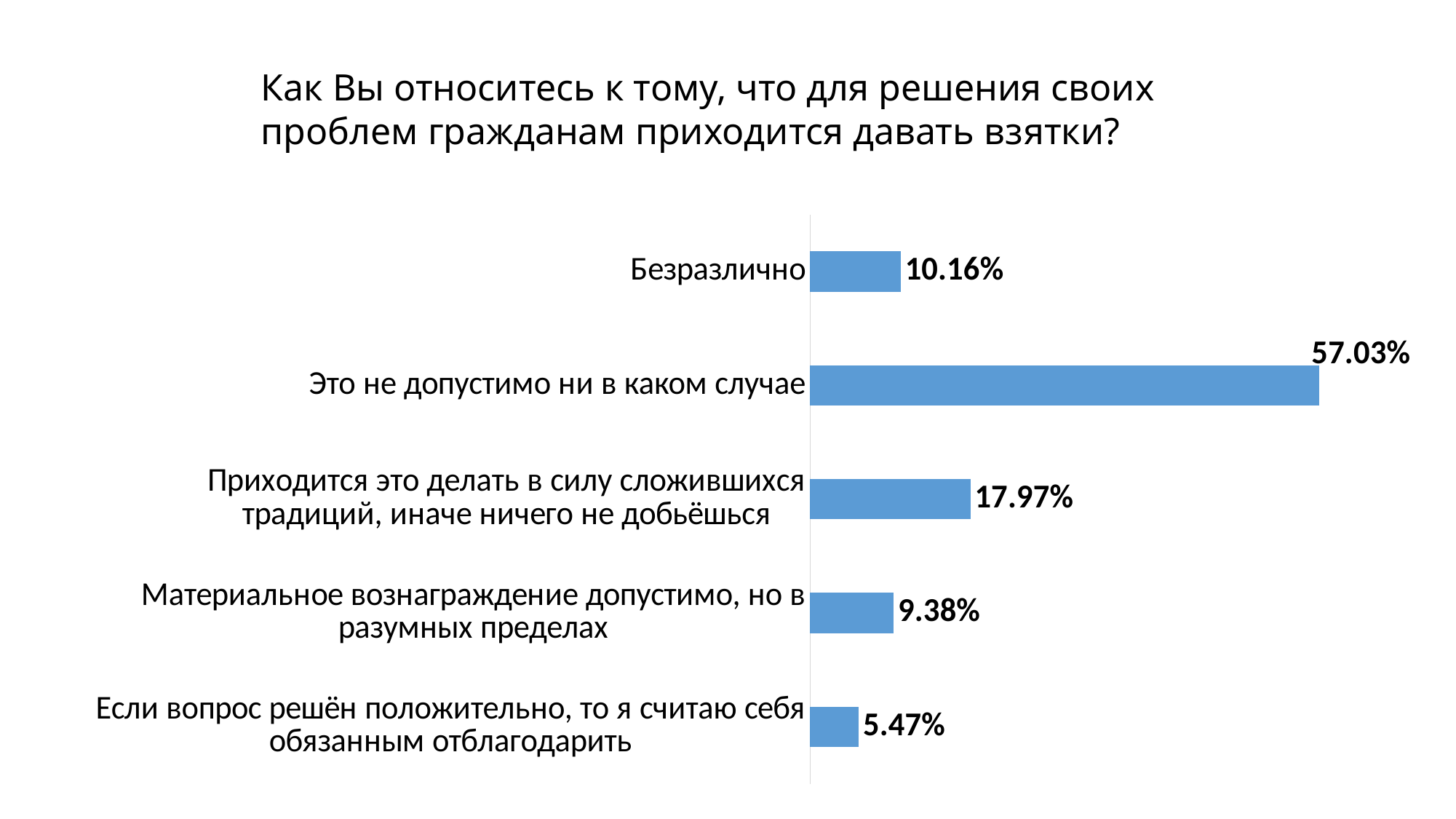
What is the value for «Приходится это делать в силу сложившихся традиций, иначе ничего не добьёшься»? 17.97% What is the difference between the values for «Это не допустимо ни в каком случае» and «Приходится это делать в силу сложившихся традиций, иначе ничего не добьёшься»? 39.06% What is the value for «Если вопрос решён положительно, то я считаю себя обязанным отблагодарить»? 5.47% What is the value for «Безразлично»? 10.16% What is the value for «Материальное вознаграждение допустимо, но в разумных пределах»? 9.38% Which category has the lowest value? Если вопрос решён положительно, то я считаю себя обязанным отблагодарить Which is larger: the value for «Безразлично» or the value for «Материальное вознаграждение допустимо, но в разумных пределах»? Безразлично What kind of chart is shown on the slide? Bar chart Which category has the highest value? Это не допустимо ни в каком случае What is the title of the chart? Как Вы относитесь к тому, что для решения своих проблем гражданам приходится давать взятки? What is the value for «Это не допустимо ни в каком случае»? 57.03% How many categories are shown in the chart? 5